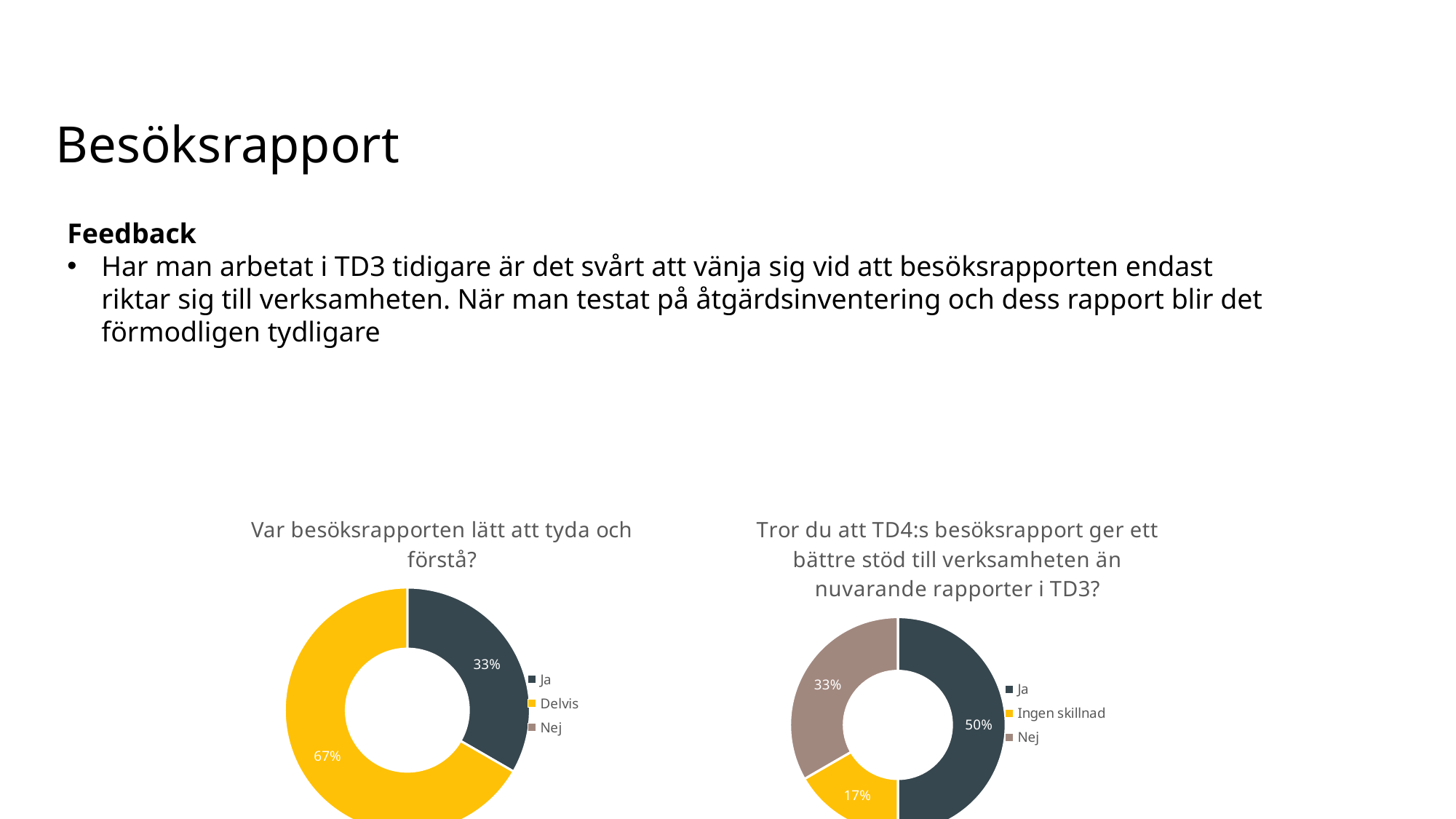
In the chart titled "Var besöksrapporten lätt att tyda och förstå?", what share is labelled for Ja? 33% In the chart on the right ("Tror du att TD4:s besöksrapport ger ett bättre stöd..."), what is the difference in percentage points between Ja and Nej? 17 percentage points In the chart on the right ("Tror du att TD4:s besöksrapport ger ett bättre stöd..."), what share is labelled for Ingen skillnad? 17% In the chart on the right ("Tror du att TD4:s besöksrapport ger ett bättre stöd..."), what colour is the Nej slice? Brownish grey In the chart titled "Var besöksrapporten lätt att tyda och förstå?", what share is labelled for Delvis? 67% In the chart on the right ("Tror du att TD4:s besöksrapport ger ett bättre stöd..."), what share is labelled for Ja? 50% What kind of chart is the one titled "Var besöksrapporten lätt att tyda och förstå?"? Doughnut (pie) chart In the chart titled "Var besöksrapporten lätt att tyda och förstå?", how many entries does the legend list? 3 In the chart on the right ("Tror du att TD4:s besöksrapport ger ett bättre stöd..."), which category has the smallest share? Ingen skillnad In the chart on the right ("Tror du att TD4:s besöksrapport ger ett bättre stöd..."), what share is labelled for Nej? 33% In the chart titled "Var besöksrapporten lätt att tyda och förstå?", which category has the largest share? Delvis In the chart on the right ("Tror du att TD4:s besöksrapport ger ett bättre stöd..."), which is larger, Ja or Nej? Ja